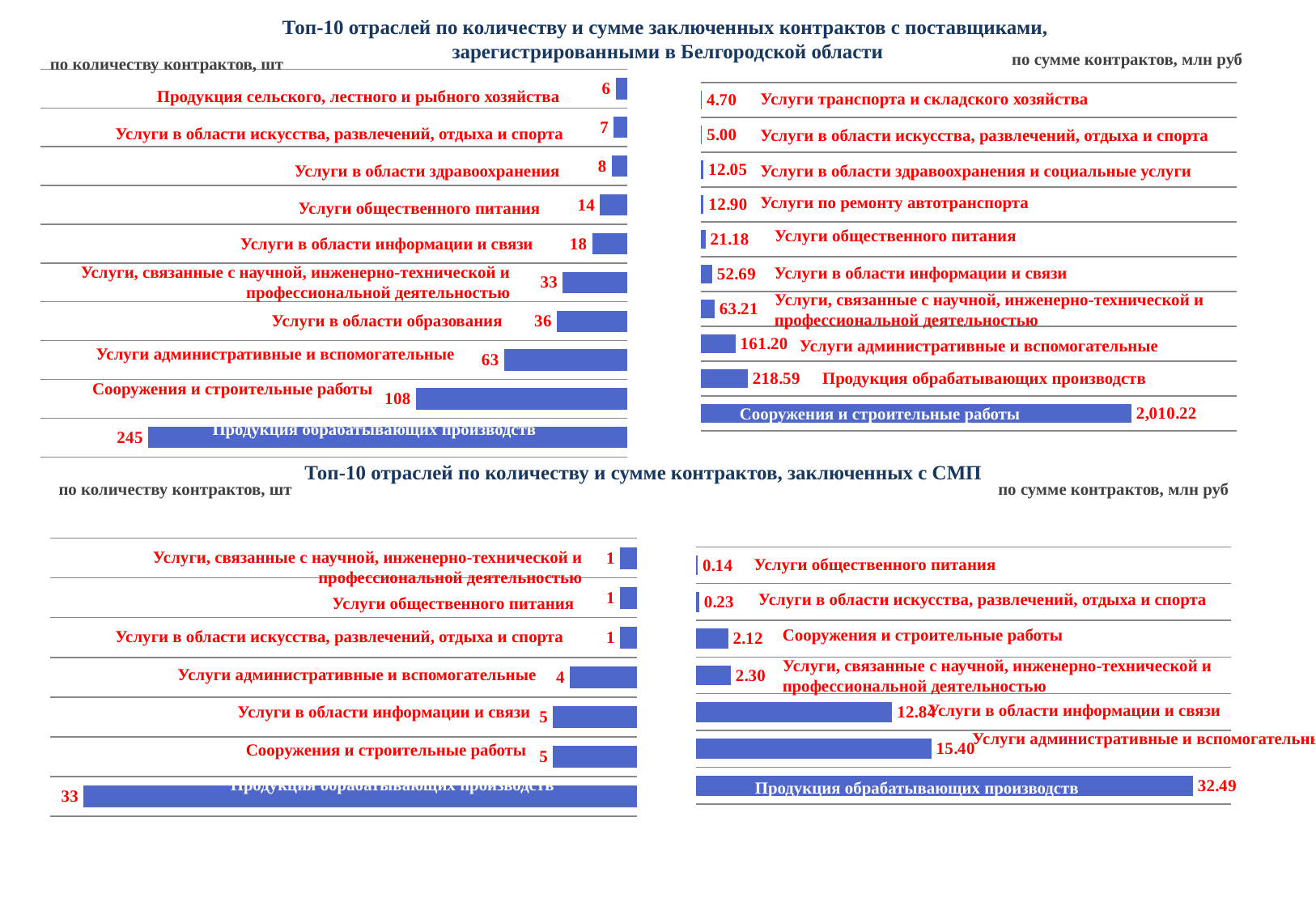
In the bottom-right chart (с СМП, по сумме контрактов, млн руб), what is the difference between Услуги административные и вспомогательные and Услуги, связанные с научной, инженерно-технической и профессиональной деятельностью? 13.10 In the bottom-left chart (с СМП, по количеству контрактов, шт), what is the value for Услуги административные и вспомогательные? 4 In the top-right chart (по сумме контрактов, млн руб), what is the value for Услуги административные и вспомогательные? 161.20 In the top-right chart (по сумме контрактов, млн руб), which is larger: Услуги в области информации и связи or Услуги общественного питания? Услуги в области информации и связи In the top-left chart (по количеству контрактов, шт), what is the difference between Услуги в области образования and Услуги общественного питания? 22 In the top-right chart (по сумме контрактов, млн руб), which category has the lowest value? Услуги транспорта и складского хозяйства In the bottom-right chart (с СМП, по сумме контрактов, млн руб), what is the value for Продукция обрабатывающих производств? 32.49 What unit is stated for the top-right chart? млн руб In the top-left chart (по количеству контрактов, шт), which category has the highest value? Продукция обрабатывающих производств What type of chart is the top-left chart? Bar chart How many categories are shown in the bottom-left chart (Топ-10 отраслей ... с СМП, по количеству контрактов, шт)? 7 In the top-left chart (по количеству контрактов, шт), what is the value for Сооружения и строительные работы? 108